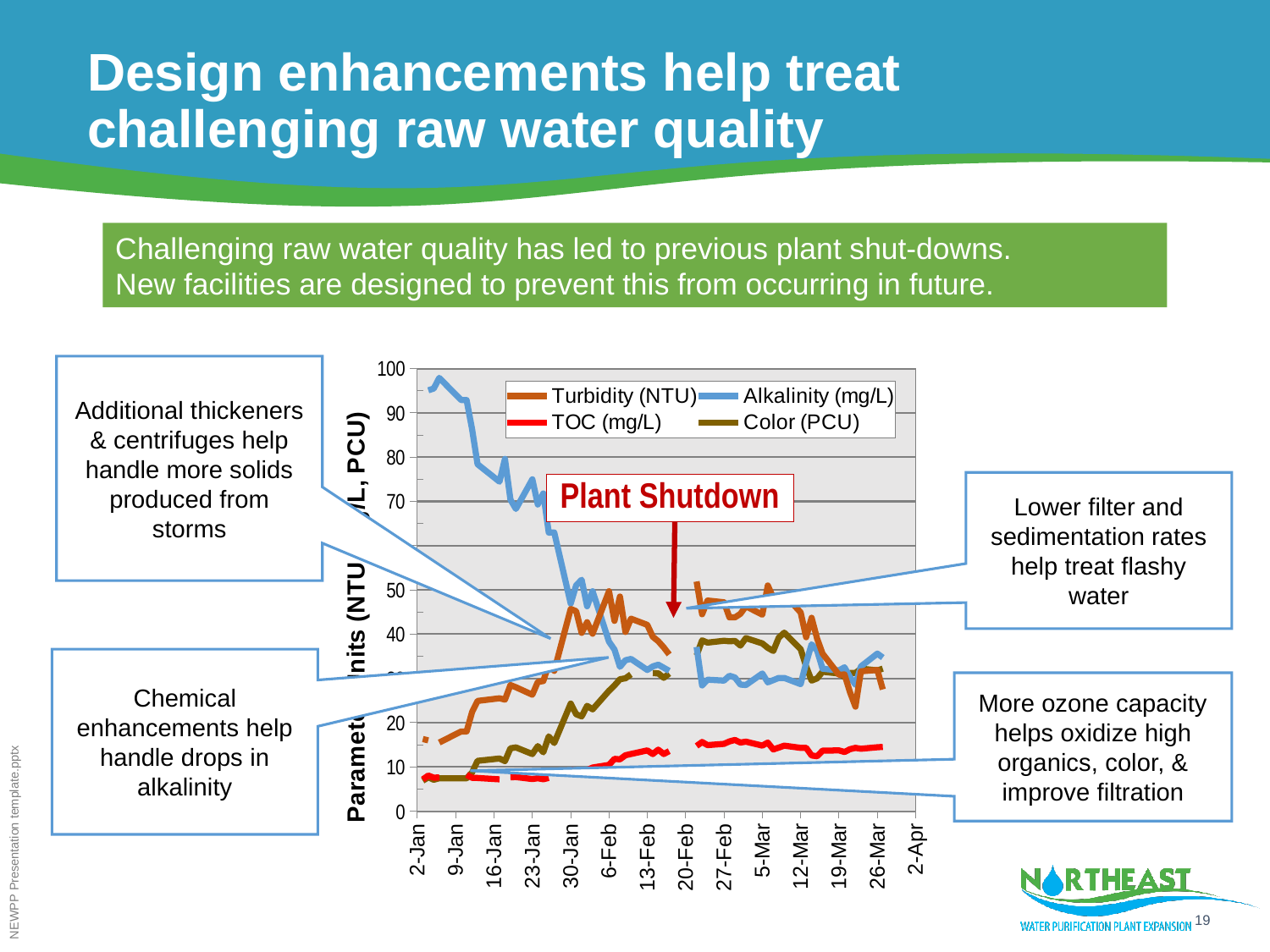
What kind of chart is shown on the slide? line chart Which series has the highest value at 2-Jan? Alkalinity (mg/L) Which series are listed in the chart legend? Turbidity (NTU), Alkalinity (mg/L), TOC (mg/L), Color (PCU) What event is annotated with a red arrow on the chart around 20-Feb? Plant Shutdown Does the Alkalinity (mg/L) line rise or fall between 2-Jan and 6-Feb? fall At 2-Jan, which is larger: Alkalinity (mg/L) or Turbidity (NTU)? Alkalinity (mg/L) Is the Alkalinity (mg/L) value at 2-Jan greater or less than 90? greater How many series does the chart legend list? 4 Is the Color (PCU) value at 27-Feb greater or less than 30? greater Does the Turbidity (NTU) line rise or fall between 2-Jan and 6-Feb? rise Is the Turbidity (NTU) value at 6-Feb greater or less than 40? greater